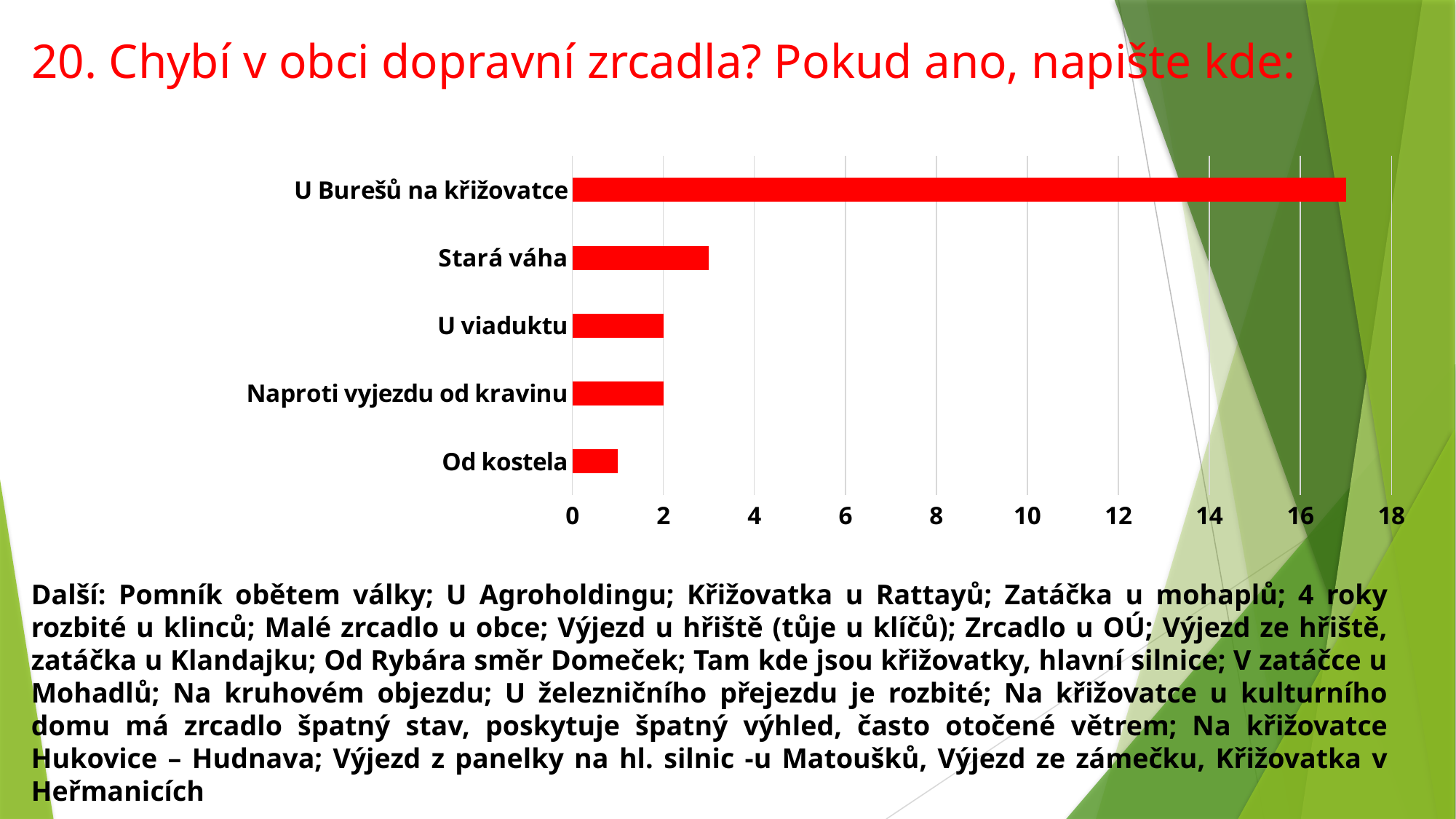
What type of chart is shown on the slide? bar chart Which has a larger value, Stará váha or U viaduktu? Stará váha Is the value for U Burešů na křižovatce greater or less than 16? greater What is the value for U viaduktu? 2 Which has a larger value, U Burešů na křižovatce or Stará váha? U Burešů na křižovatce Which location has the highest value in the chart? U Burešů na křižovatce Is the value for Stará váha greater or less than 4? less Which location has the lowest value in the chart? Od kostela Is the value for Od kostela greater or less than 2? less How many categories (locations) are plotted in the chart? 5 What is the value for Naproti vyjezdu od kravinu? 2 What colour are the bars in the chart? red